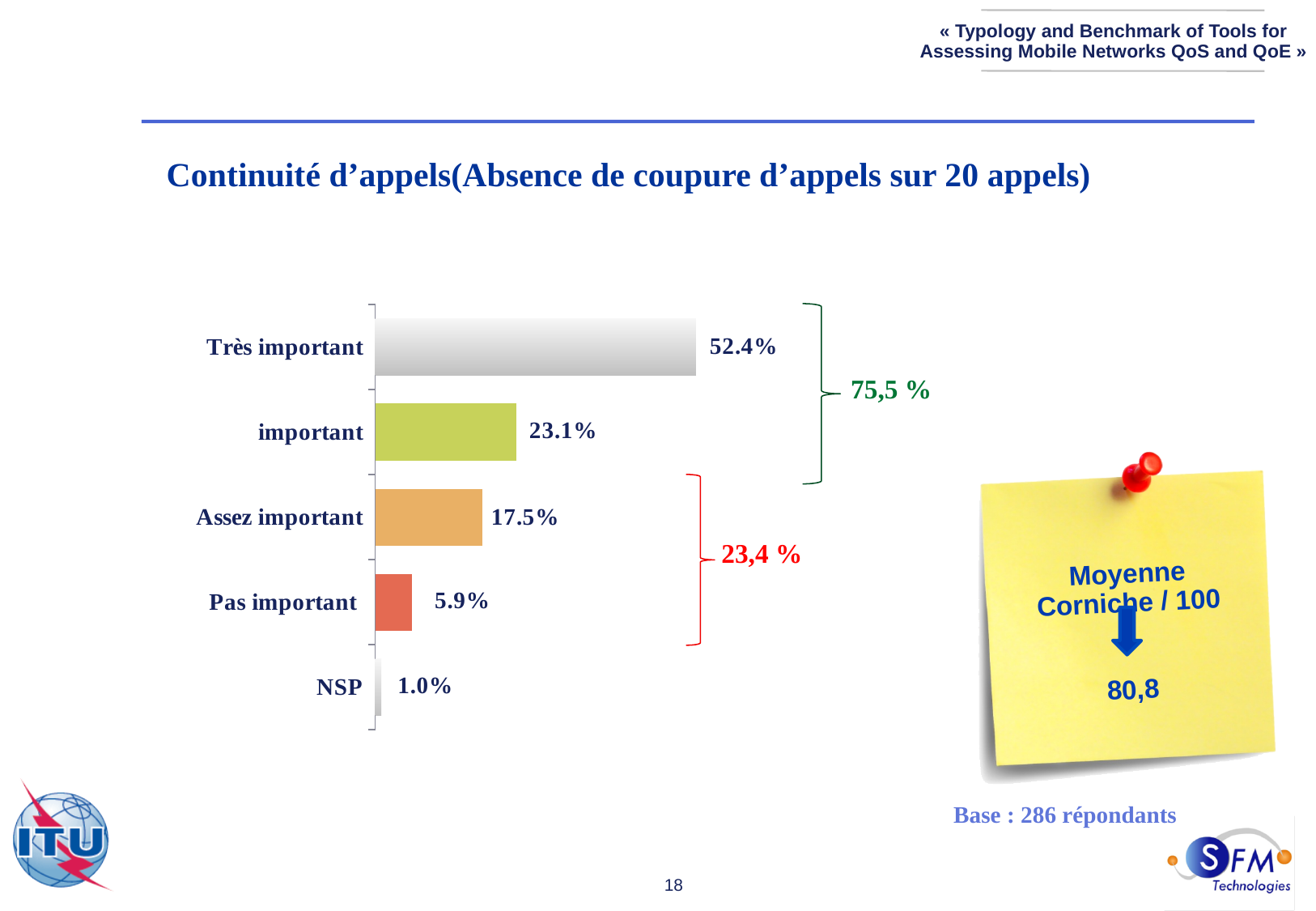
What is the difference between the 'Très important' and 'important' values? 29.3% What percentage of respondents rated call continuity as 'Très important'? 52.4% How many categories are shown in the chart? 5 What combined percentage is shown by the green bracket grouping 'Très important' and 'important'? 75,5 % What kind of chart is shown on the slide? Bar chart What is the 'Moyenne Corniche / 100' value shown on the sticky note? 80,8 Which category has the highest value? Très important Which category has the lowest value? NSP What is the value shown for the 'important' category? 23.1% What is the value shown for 'NSP'? 1.0% Which is larger, 'Assez important' or 'Pas important'? Assez important What is the value shown for 'Assez important'? 17.5%